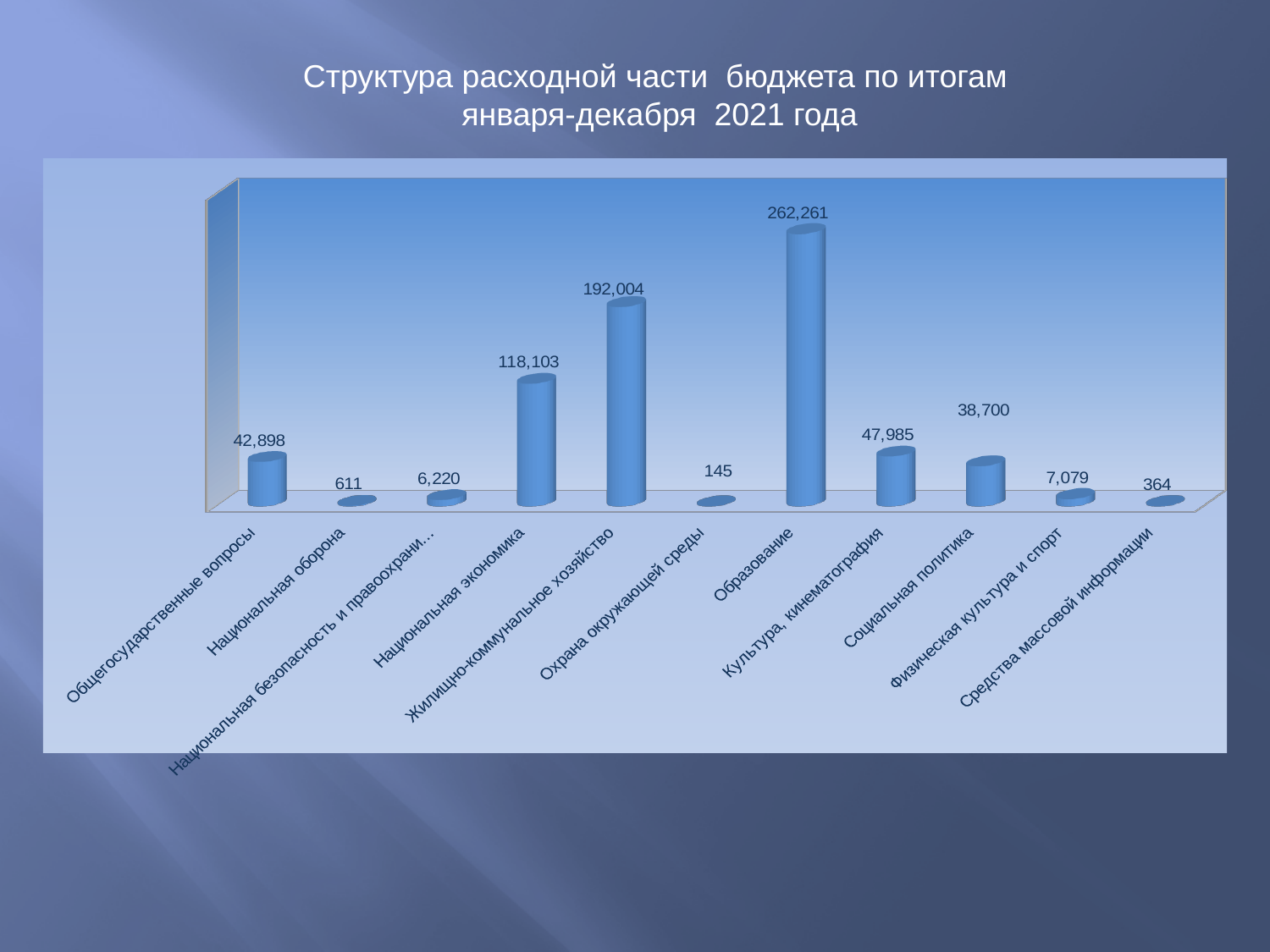
What kind of chart is shown on the slide? Bar chart What is the title of the slide? Структура расходной части бюджета по итогам января-декабря 2021 года What is the value for Социальная политика? 38,700 Which category has the highest value? Образование Which category has the lowest value? Охрана окружающей среды What is the value for Жилищно-коммунальное хозяйство? 192,004 What is the difference between the values for Образование and Жилищно-коммунальное хозяйство? 70,257 What is the value for Охрана окружающей среды? 145 How many categories are shown on the chart? 11 Which is larger, the value for Национальная экономика or the value for Общегосударственные вопросы? Национальная экономика What is the value for Образование? 262,261 What is the difference between the values for Культура, кинематография and Социальная политика? 9,285